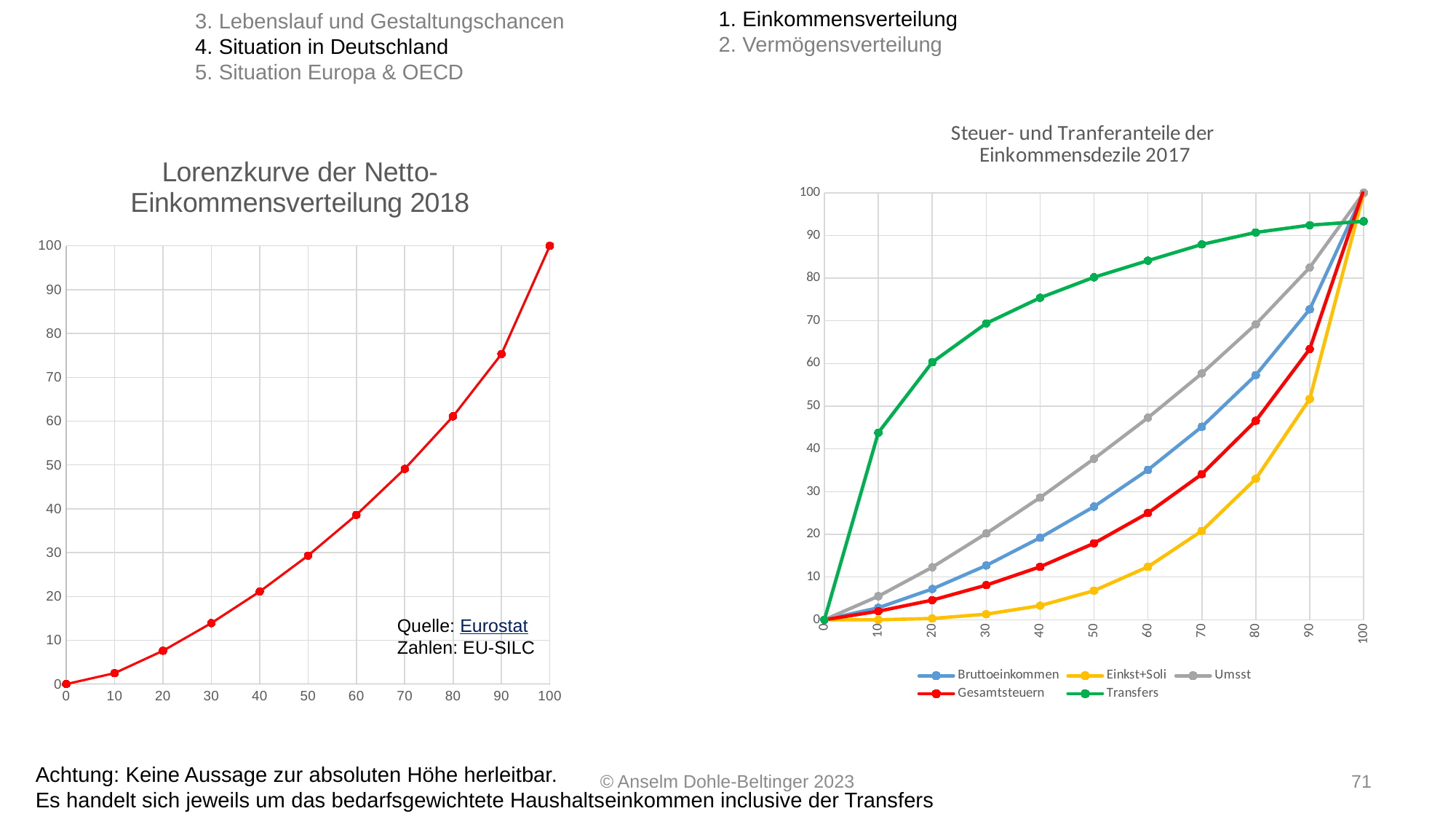
In the 'Lorenzkurve der Netto-Einkommensverteilung 2018' chart, what is the value at x = 100? 100 In the 'Lorenzkurve der Netto-Einkommensverteilung 2018' chart, is the value at x = 90 greater or less than 70? greater How many series does the legend of the 'Steuer- und Tranferanteile der Einkommensdezile 2017' chart list? 5 In the 'Steuer- und Tranferanteile der Einkommensdezile 2017' chart, which is larger at x = 90: Umsst or Bruttoeinkommen? Umsst In the 'Lorenzkurve der Netto-Einkommensverteilung 2018' chart, is the value at x = 60 greater or less than 40? less In the 'Lorenzkurve der Netto-Einkommensverteilung 2018' chart, do the values rise or fall as x increases? rise What type of chart is the 'Lorenzkurve der Netto-Einkommensverteilung 2018' chart? line chart In the 'Steuer- und Tranferanteile der Einkommensdezile 2017' chart, which series has the highest value at x = 50? Transfers In the 'Steuer- und Tranferanteile der Einkommensdezile 2017' chart, which colour is used for the Transfers series? green In the 'Steuer- und Tranferanteile der Einkommensdezile 2017' chart, is the Transfers value at x = 10 greater or less than 40? greater In the 'Steuer- und Tranferanteile der Einkommensdezile 2017' chart, which series has the lowest value at x = 50? Einkst+Soli In the 'Lorenzkurve der Netto-Einkommensverteilung 2018' chart, how many data points are plotted? 11